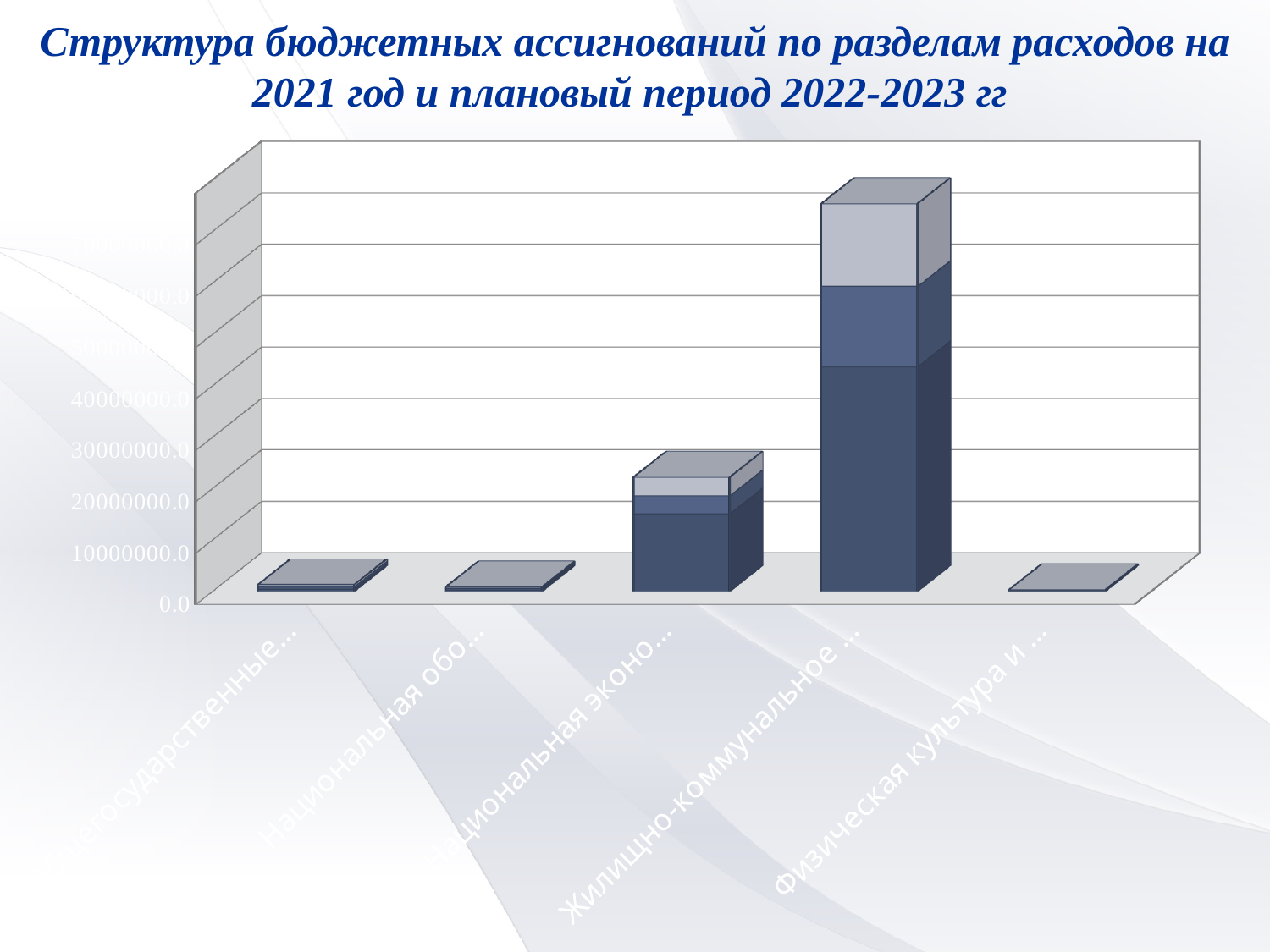
Is the total value of the bar for "Жилищно-коммунальное ..." greater or less than 40000000.0? greater Is the total value of the bar for "Национальная эконо..." greater or less than 10000000.0? greater Which bar is taller: the one for "Жилищно-коммунальное ..." or the one for "Национальная эконо..."? Жилищно-коммунальное ... Is the total value of the bar for "Национальная эконо..." greater or less than 40000000.0? less How many categories are plotted along the x axis of the chart? 5 What is the title of the slide containing the chart? Структура бюджетных ассигнований по разделам расходов на 2021 год и плановый период 2022-2023 гг Do the bar heights rise steadily from left to right along the x axis? No How many stacked segments make up the bar for "Жилищно-коммунальное ..."? 3 What is the lowest tick label shown on the vertical axis of the chart? 0.0 Which category has the tallest bar in the chart? Жилищно-коммунальное ... What kind of chart is shown on the slide? bar chart